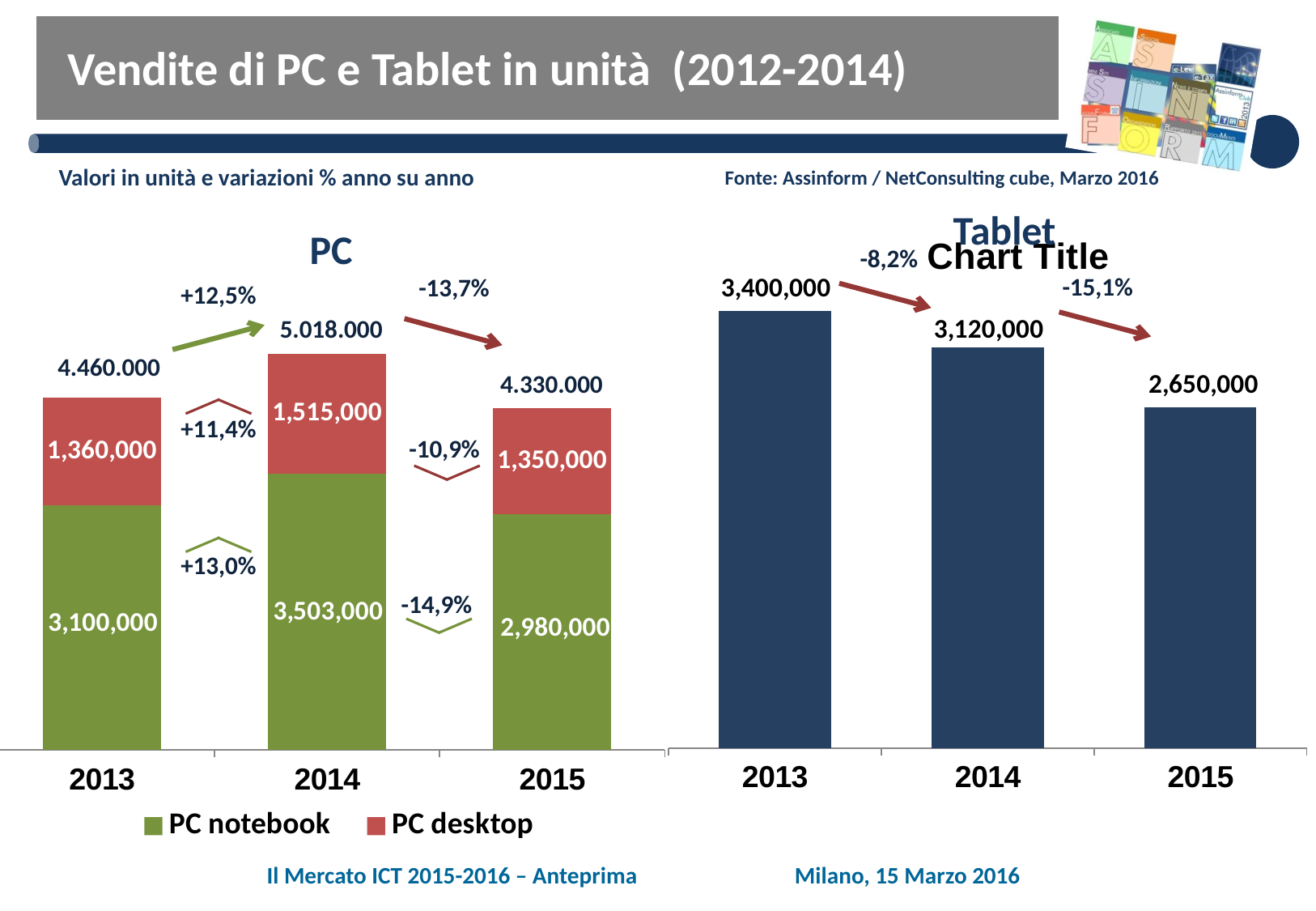
In the Tablet chart, what is the difference between the 2013 and 2014 values? 280,000 How many series does the legend of the PC chart list? 2 In the PC chart, what is the total of the stacked bar for 2014? 5.018.000 In the Tablet chart, what is the value for 2015? 2,650,000 What kind of chart is the Tablet chart? bar chart In the Tablet chart, do the values rise or fall from 2013 to 2015? fall How many years are shown on the x axis of the Tablet chart? 3 In the PC chart, which year has the lowest PC notebook value? 2015 In the PC chart, what is the value for PC desktop in 2013? 1,360,000 In the PC chart, is the PC desktop value for 2014 larger or smaller than the PC desktop value for 2015? larger In the Tablet chart, which year has the highest value? 2013 In the PC chart, what is the value for PC notebook in 2014? 3,503,000